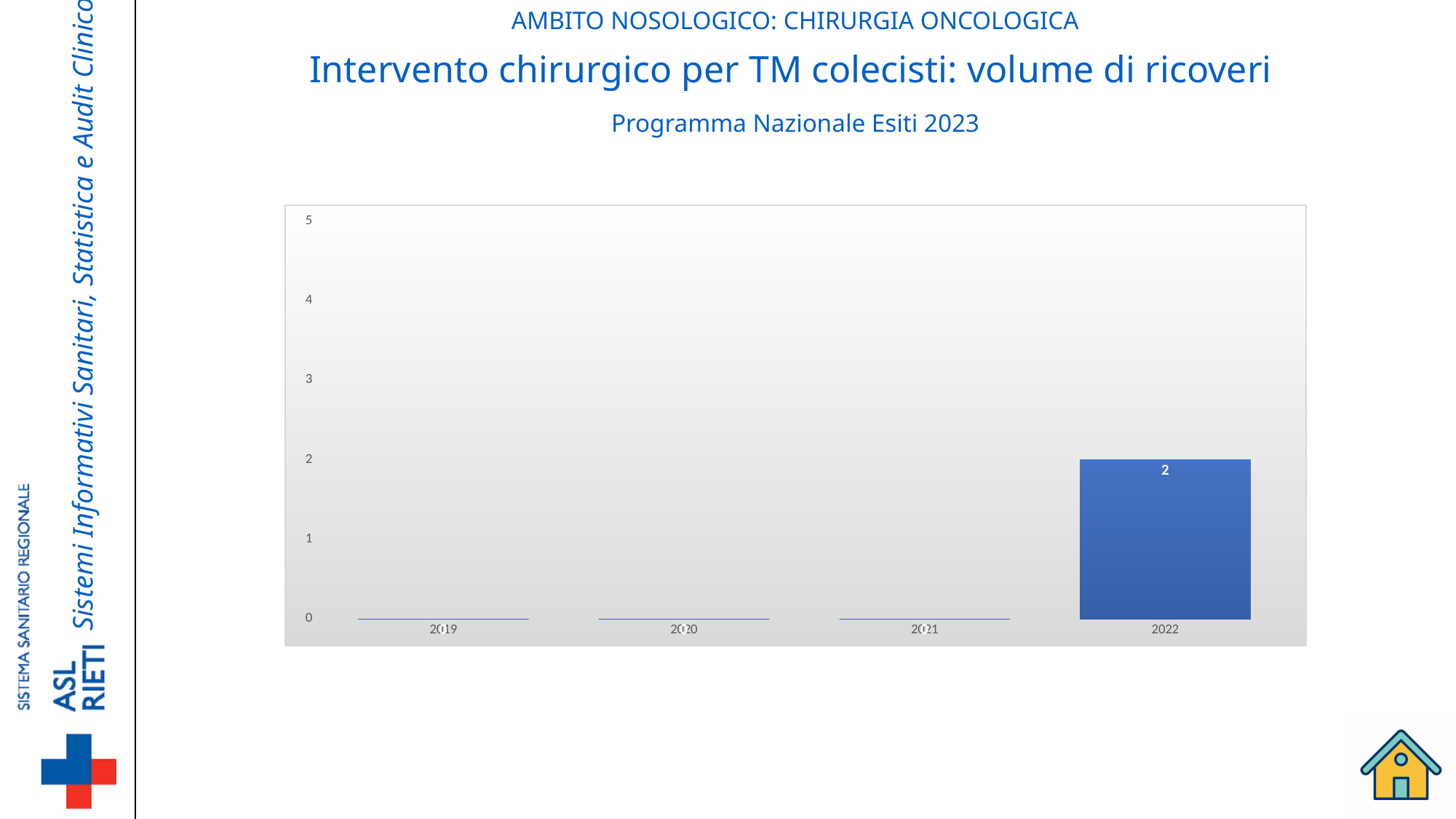
What kind of chart is shown? bar chart What is the difference between the values for 2022 and 2021? 2 What is the title of the slide above the chart? Intervento chirurgico per TM colecisti: volume di ricoveri What is the value for 2022? 2 What is the highest value shown on the y axis? 5 How many years are shown on the x axis? 4 Which is larger, the value for 2021 or the value for 2022? 2022 Is the value for 2022 greater or less than 3? less Is the value for 2022 greater or less than 1? greater Do the values rise or fall from 2021 to 2022? rise What is the value for 2019? 0 Which year has the highest value? 2022